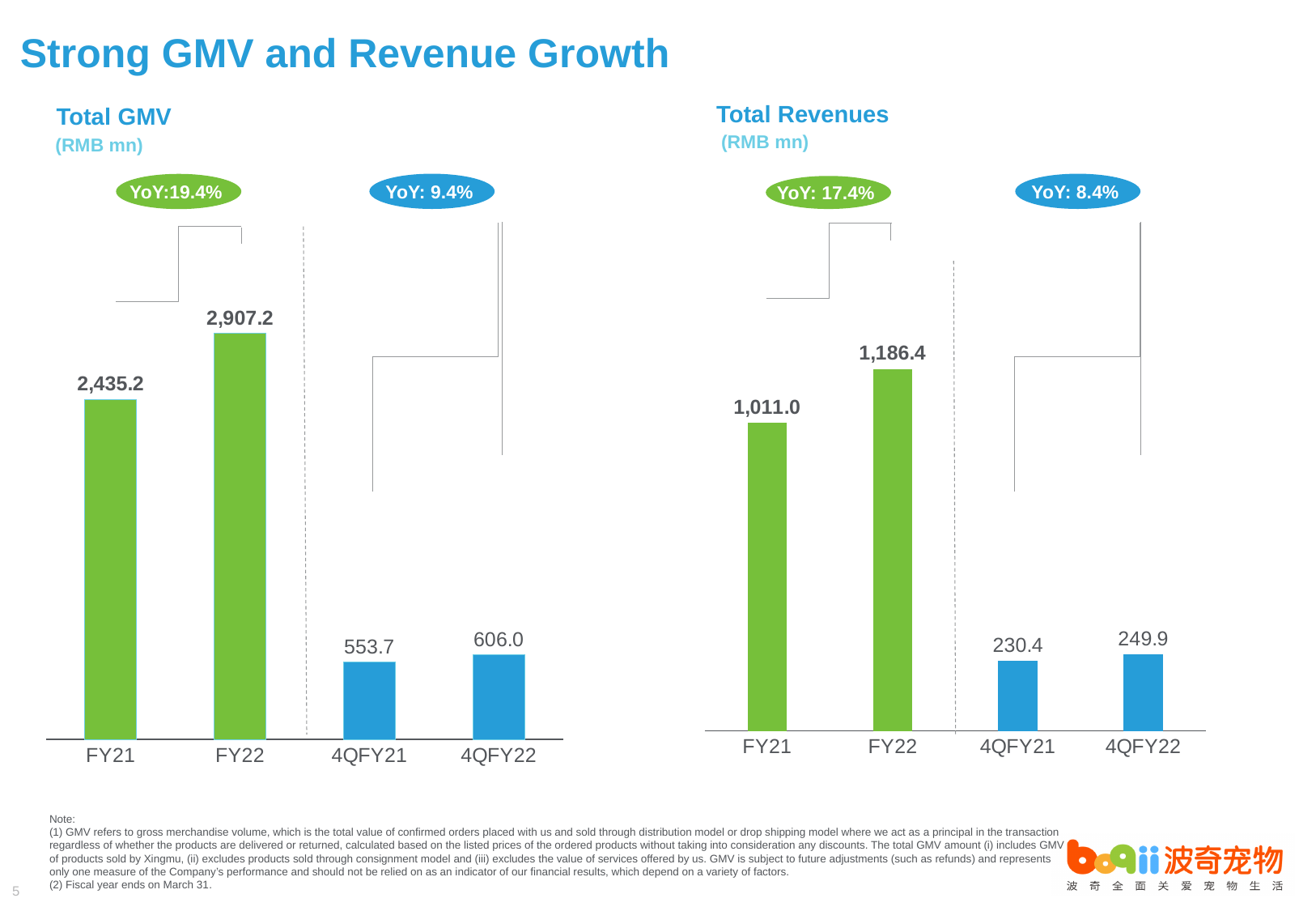
In the Total Revenues chart, what is the value for 4QFY22? 249.9 How many categories are shown in the Total GMV chart? 4 In the Total GMV chart, what is the value for FY22? 2,907.2 In the Total GMV chart, what is the difference between the FY22 and FY21 values? 472.0 In the Total Revenues chart, which is larger, the FY22 value or the FY21 value? FY22 In the Total Revenues chart, what is the difference between the 4QFY22 and 4QFY21 values? 19.5 What kind of chart is the Total Revenues chart? Bar chart In the Total Revenues chart, which category has the lowest value? 4QFY21 In the Total GMV chart, what is the value for 4QFY21? 553.7 In the Total Revenues chart, what is the value for FY21? 1,011.0 In the Total GMV chart, which category has the highest value? FY22 In the Total GMV chart, what YoY growth is shown for the full-year comparison (FY21 to FY22)? 19.4%